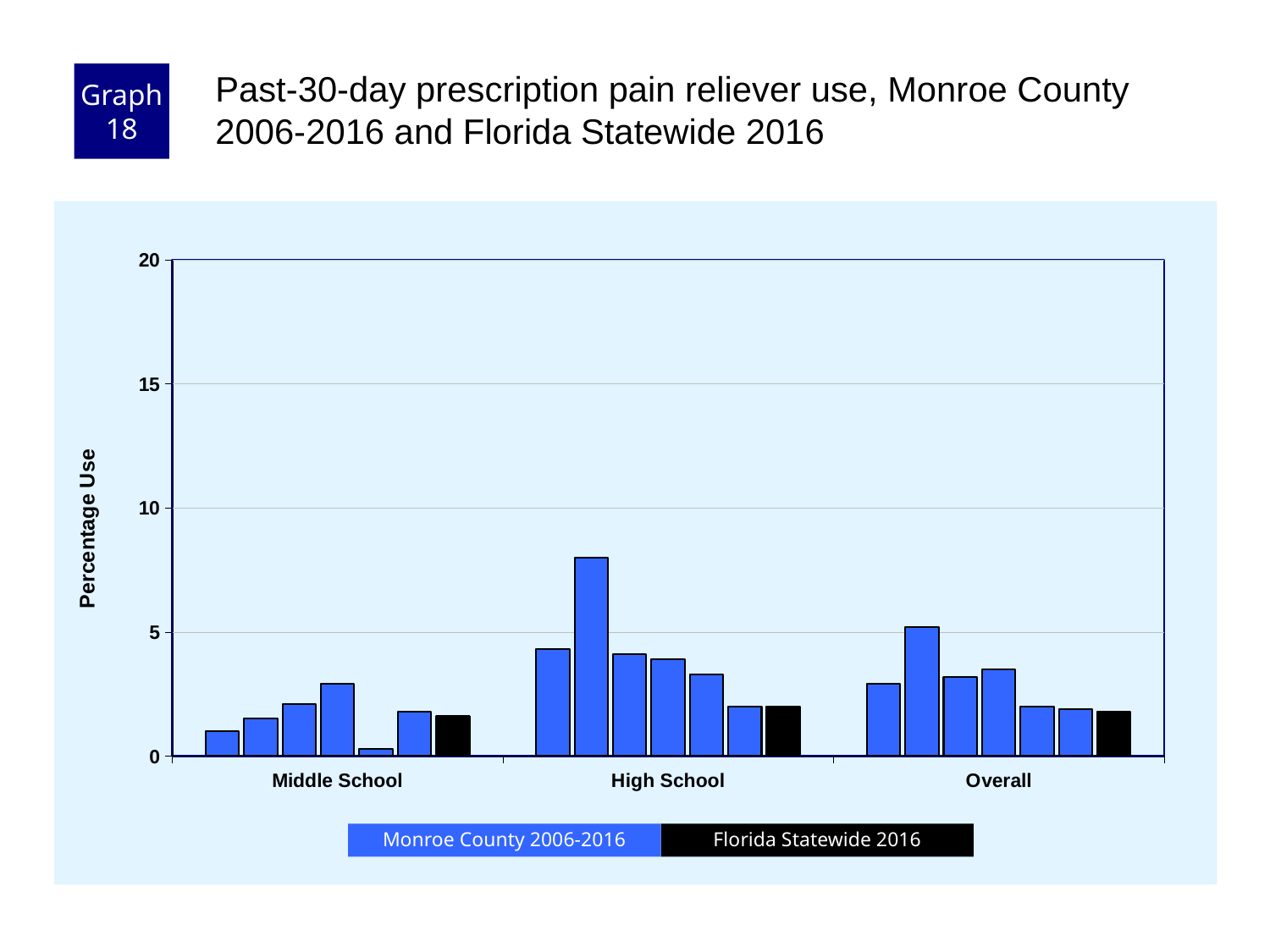
What kind of chart is shown on the slide? bar chart Is the tallest Monroe County 2006-2016 bar for High School greater or less than 5? greater What colour represents Florida Statewide 2016 in the legend? black Which is larger for Overall: the tallest Monroe County 2006-2016 bar or the Florida Statewide 2016 bar? Monroe County 2006-2016 How many series does the legend list? 2 Which x-axis category contains the tallest bar in the chart? High School Which is larger: the tallest Monroe County bar for High School or the tallest Monroe County bar for Middle School? High School Is the tallest bar in the whole chart greater or less than 10? less What is the label on the y axis? Percentage Use Is the Florida Statewide 2016 value for High School greater or less than 5? less How many categories are shown along the x axis? 3